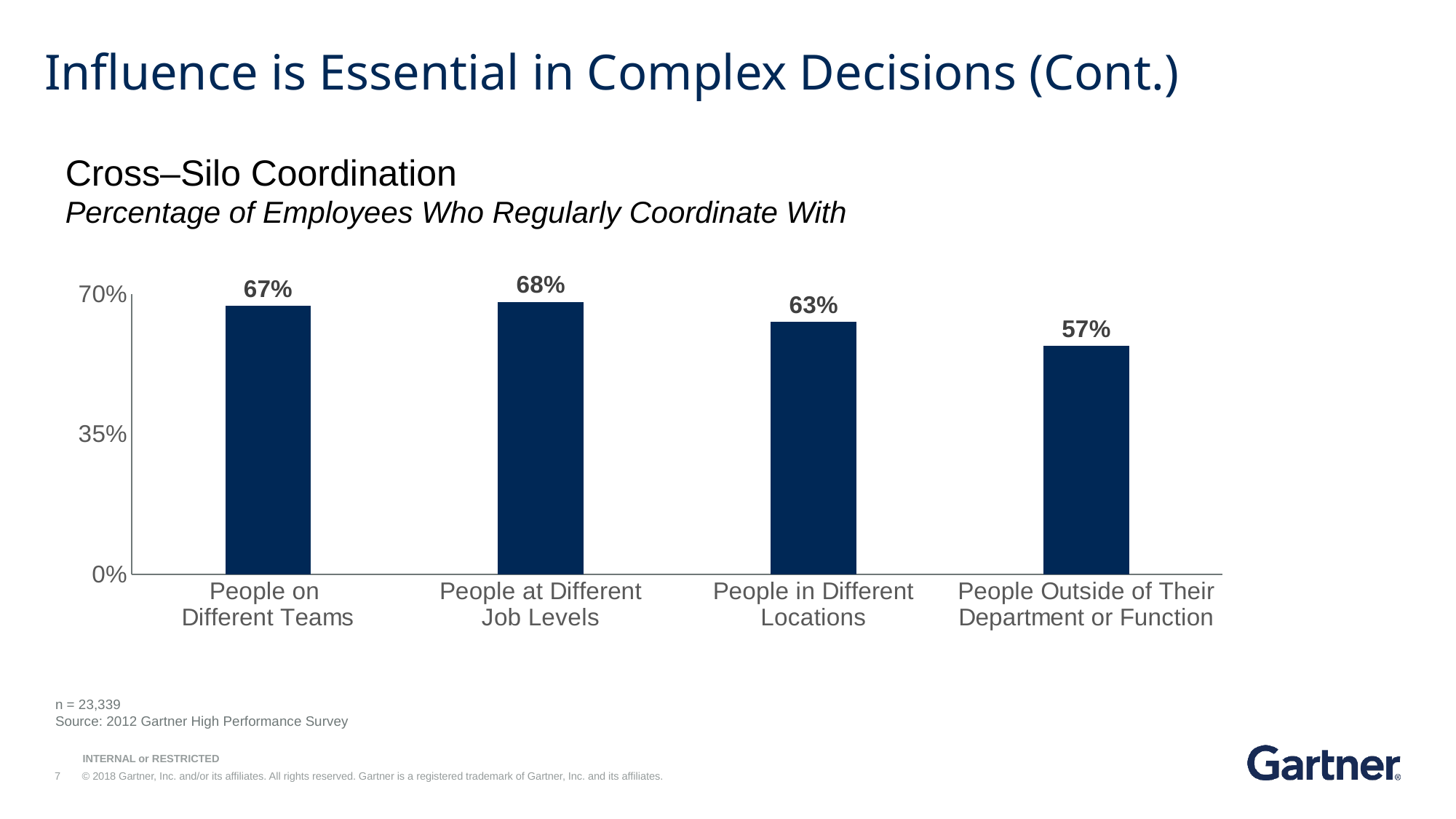
Which category has the lowest value? People Outside of Their Department or Function What is the value for People in Different Locations? 63% What is the title of the chart? Cross–Silo Coordination What is the value for People at Different Job Levels? 68% Which category has the highest value? People at Different Job Levels What percentage of employees regularly coordinate with People on Different Teams? 67% What is the difference between the values for People on Different Teams and People in Different Locations? 4% How many categories are shown in the chart? 4 Which is larger: the value for People in Different Locations or People Outside of Their Department or Function? People in Different Locations What is the value for People Outside of Their Department or Function? 57% What is the difference between the values for People at Different Job Levels and People Outside of Their Department or Function? 11% What kind of chart is shown on the slide? Bar chart